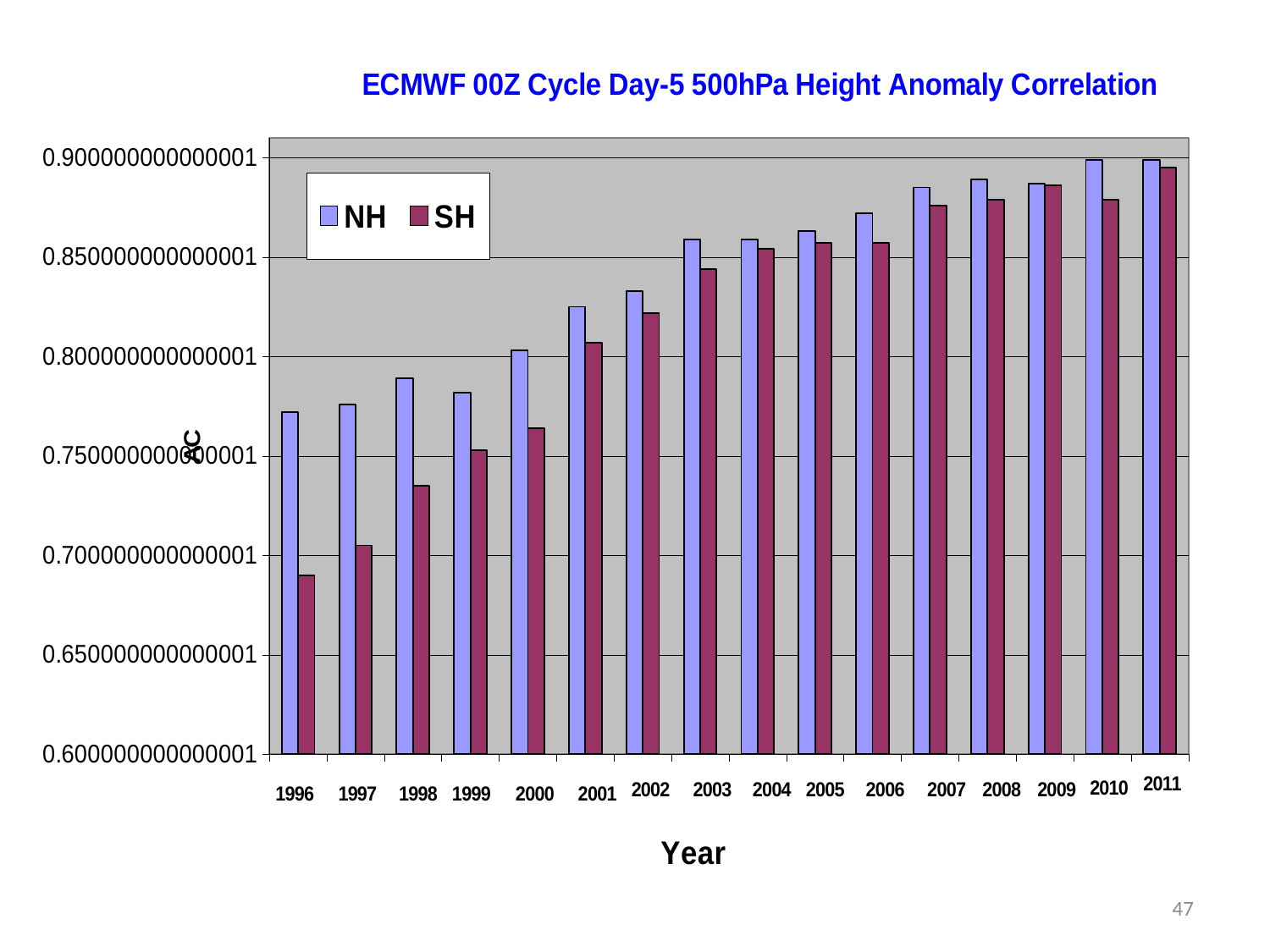
Do the NH values generally rise or fall from 1996 to 2011? rise How many series does the legend list? 2 How many years are shown along the x axis? 16 What is the label on the x axis of the chart? Year Which year has the lowest SH value? 1996 Which year has the highest SH value? 2011 Which is larger, the SH value for 1996 or the SH value for 2011? 2011 Is the SH value for 1998 greater or less than 0.75? less Is the NH value for 2011 greater or less than 0.85? greater Is the SH value for 1996 greater or less than 0.70? less What kind of chart is shown on the slide? bar chart In 1996, which is larger, the NH value or the SH value? NH